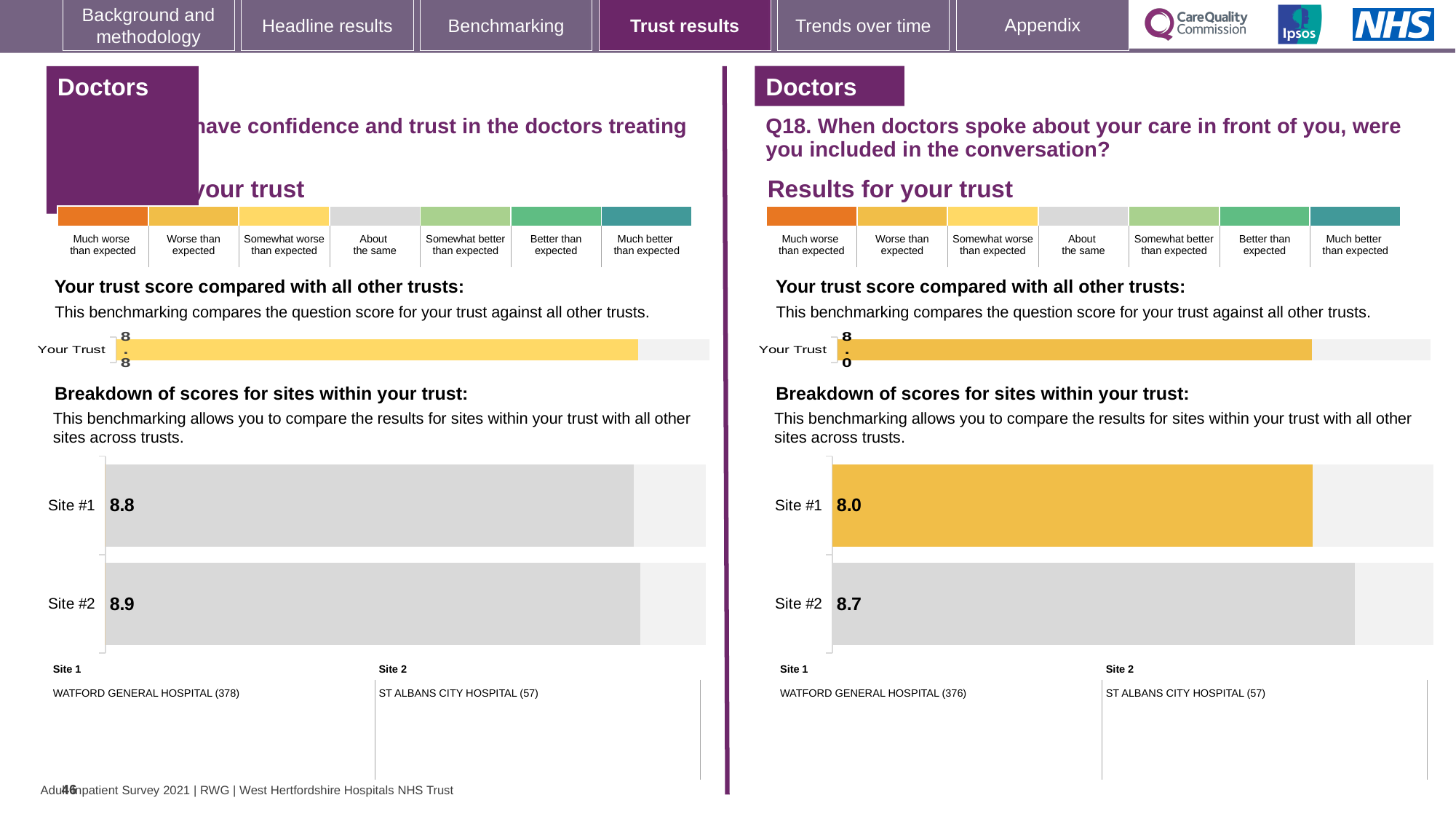
On the right-hand site breakdown chart for Q18, which site's bar is coloured yellow rather than grey? Site #1 On the right-hand site breakdown chart for Q18, what is the difference between the Site #2 and Site #1 scores? 0.7 What type of chart is the site breakdown chart on the left-hand side of the slide? Bar chart On the right-hand site breakdown chart for Q18, which site has the higher score? Site #2 On the right-hand 'Your trust score compared with all other trusts' chart for Q18, what is the score for Your Trust? 8.0 On the right-hand chart for Q18, what is the score for Site #1? 8.0 How many sites are shown on the right-hand site breakdown chart for Q18? 2 On the right-hand chart for Q18, what is the score for Site #2? 8.7 On the left-hand 'Your trust score compared with all other trusts' chart, what is the score for Your Trust? 8.8 On the left-hand site breakdown chart, what is the difference between the Site #2 and Site #1 scores? 0.1 On the left-hand site breakdown chart, what is the score for Site #1? 8.8 On the left-hand site breakdown chart, what is the score for Site #2? 8.9